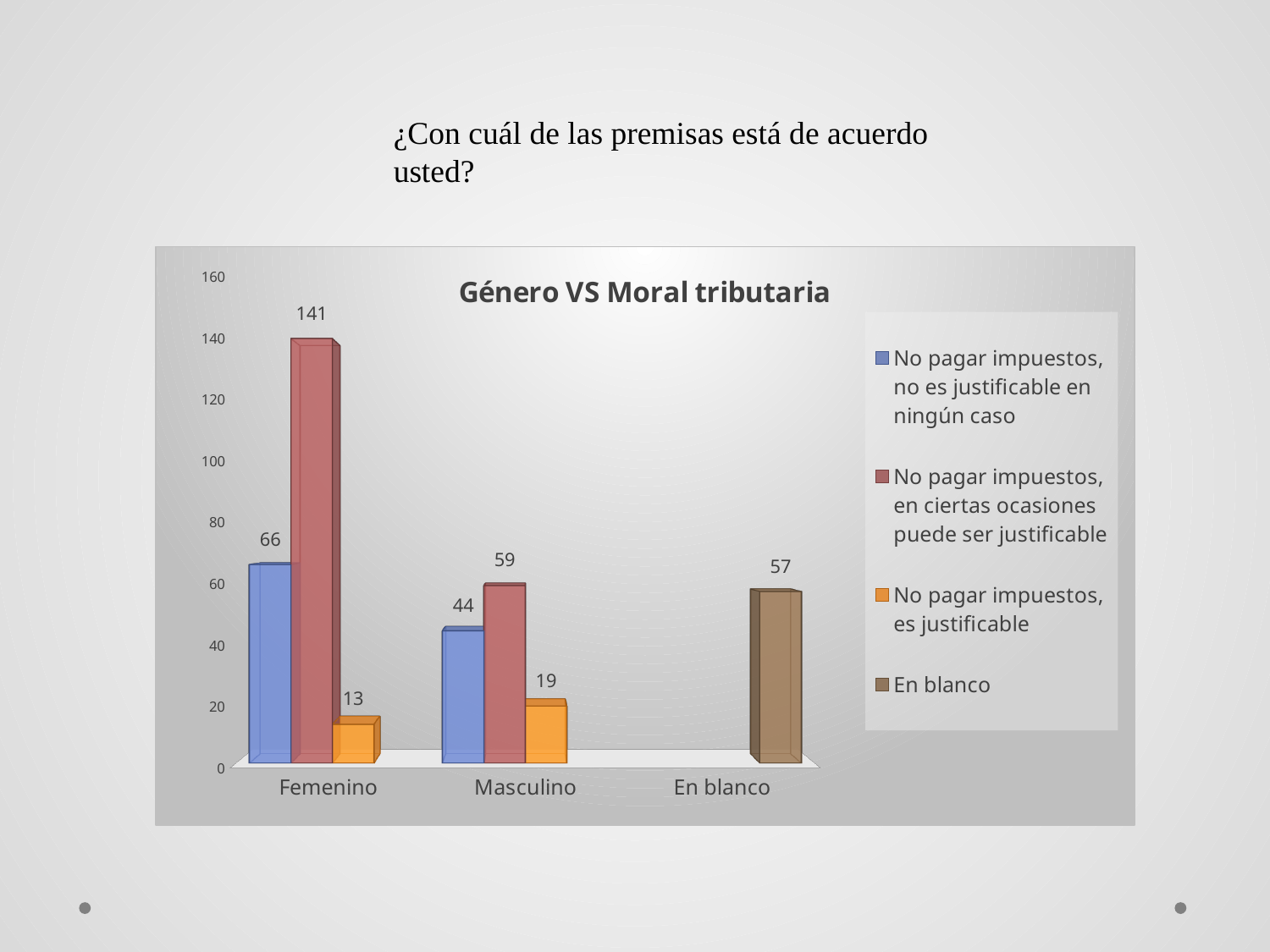
What is the title of the chart? Género VS Moral tributaria How many series does the legend list? 4 What is the difference between the Masculino values for 'No pagar impuestos, en ciertas ocasiones puede ser justificable' and 'No pagar impuestos, es justificable'? 40 What is the value of the 'En blanco' series in the En blanco category? 57 How many categories are shown on the x axis? 3 Which is larger: the Femenino value for 'No pagar impuestos, no es justificable en ningún caso' or the Masculino value for the same series? Femenino Which category has the highest value for 'No pagar impuestos, en ciertas ocasiones puede ser justificable'? Femenino What is the value for 'No pagar impuestos, no es justificable en ningún caso' in the Masculino category? 44 What is the value for 'No pagar impuestos, es justificable' in the Femenino category? 13 What is the difference between the Femenino and Masculino values for 'No pagar impuestos, en ciertas ocasiones puede ser justificable'? 82 What type of chart is shown on the slide? Bar chart What is the value for 'No pagar impuestos, en ciertas ocasiones puede ser justificable' in the Femenino category? 141